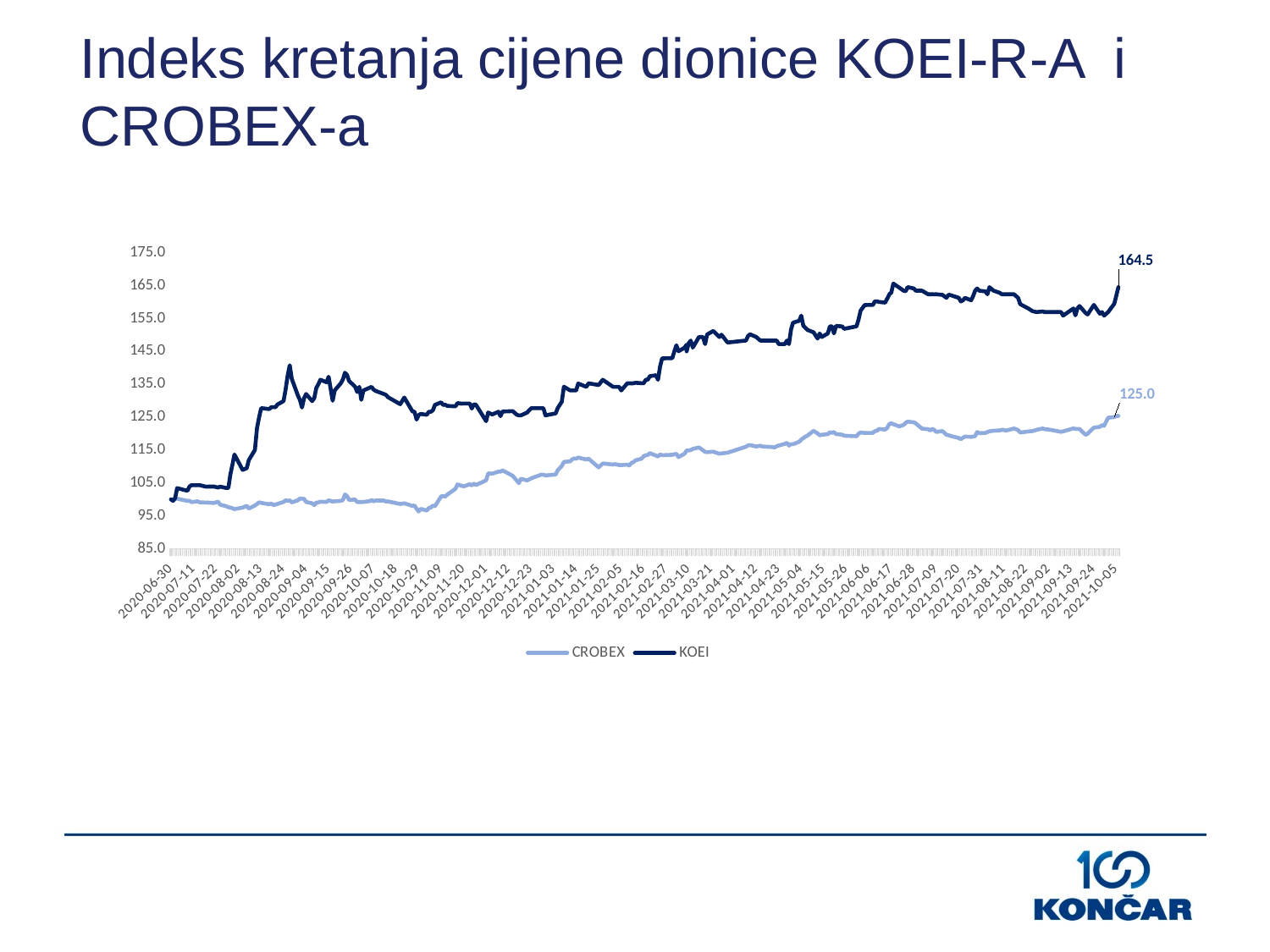
Is the value for KOEI at 2020-06-30 greater or less than 105.0? less Does the KOEI series overall rise or fall from 2020-06-30 to 2021-10-05? rise What is the final labelled value of the KOEI series? 164.5 What is the title of the chart on the slide? Indeks kretanja cijene dionice KOEI-R-A i CROBEX-a How many series does the legend list? 2 Which series has the higher value at the end of the chart, KOEI or CROBEX? KOEI What kind of chart is shown on the slide? line chart What is the final labelled value of the CROBEX series? 125.0 What is the difference between the final labelled values of KOEI and CROBEX? 39.5 What are the two series named in the legend? CROBEX and KOEI Does the CROBEX series overall rise or fall from 2020-06-30 to 2021-10-05? rise Is the value for KOEI around 2021-06-17 greater or less than 155.0? greater